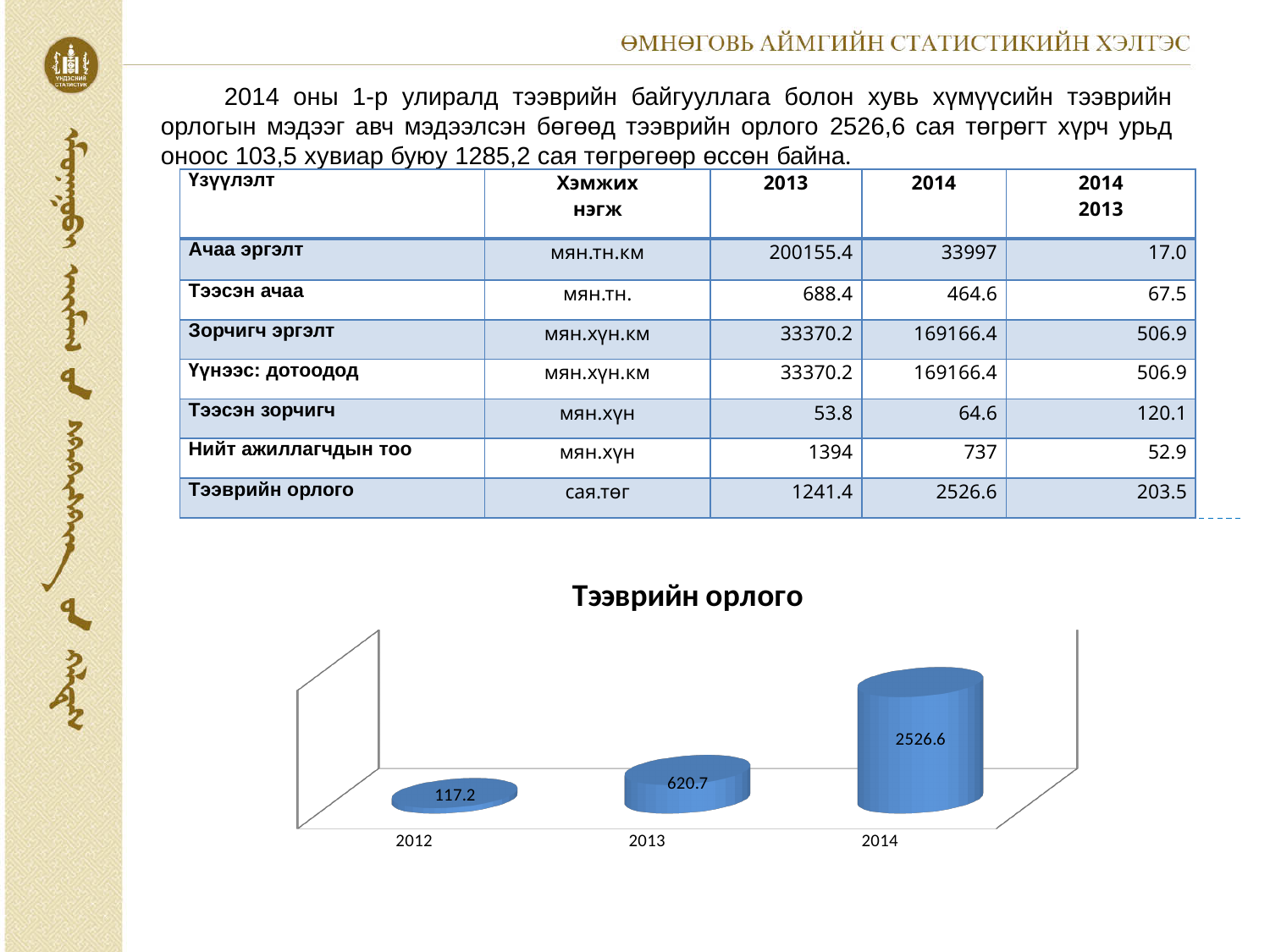
Do the values in the chart rise or fall from 2012 to 2014? rise What is the value for 2013 in the chart? 620.7 Which is larger in the chart, the value for 2013 or the value for 2012? 2013 What is the difference between the values for 2013 and 2012 in the chart? 503.5 What kind of chart is shown on the slide? bar chart Which year has the lowest value in the chart? 2012 What is the value for 2012 in the chart? 117.2 Which year has the highest value in the chart? 2014 What is the title of the chart? Тээврийн орлого What is the value for 2014 in the chart? 2526.6 How many years are shown on the x axis of the chart? 3 What is the difference between the values for 2014 and 2013 in the chart? 1905.9